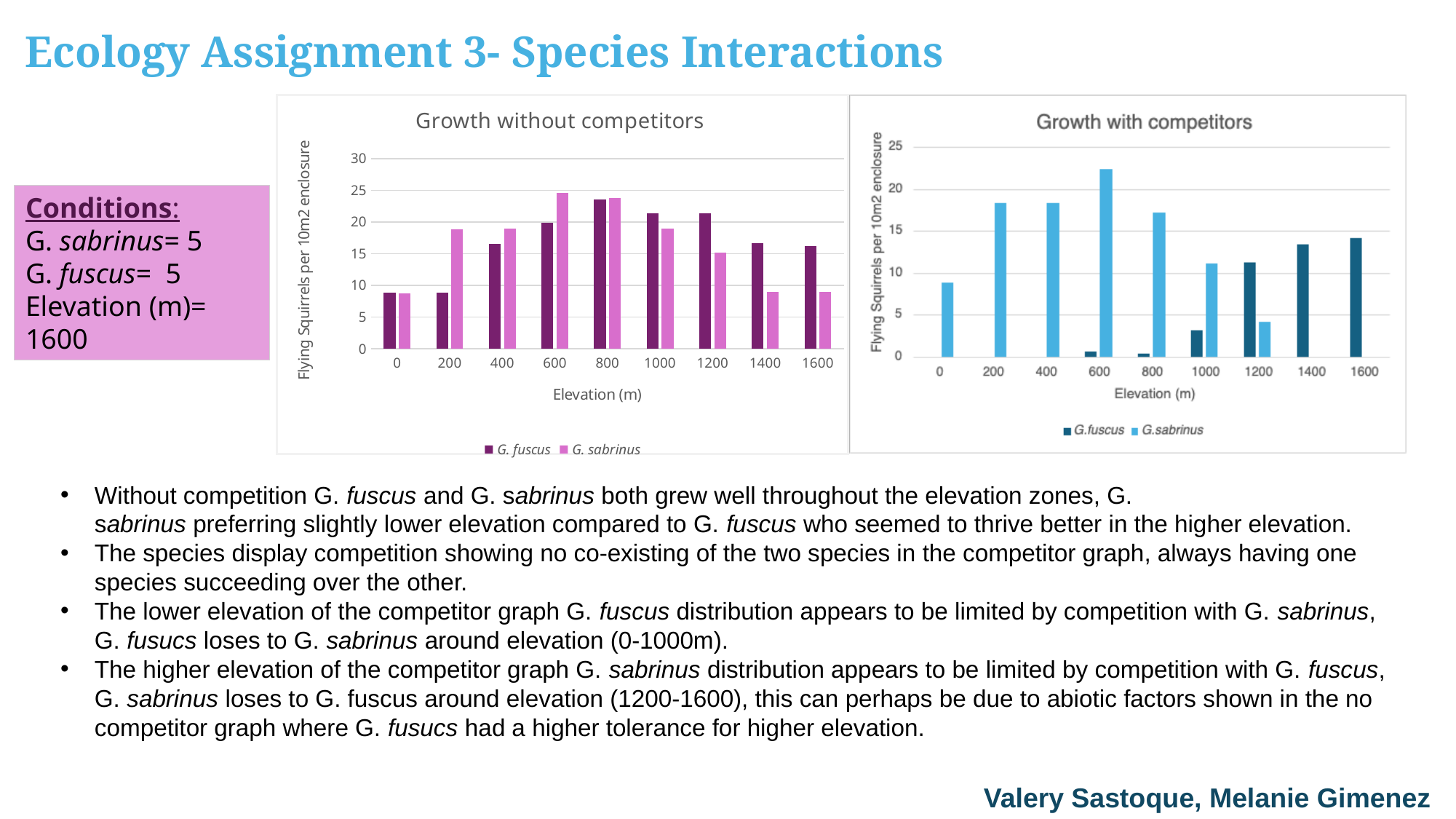
In the 'Growth with competitors' chart, is the value for G. sabrinus at elevation 600 greater or less than 20? greater In the 'Growth without competitors' chart, is the value for G. fuscus at elevation 400 greater or less than 15? greater What is the y-axis label of the 'Growth without competitors' chart? Flying Squirrels per 10m2 enclosure In the 'Growth with competitors' chart, do the G. sabrinus values rise or fall from elevation 600 to 1600? fall In the 'Growth with competitors' chart, do the G. fuscus values generally rise or fall as elevation increases? rise In the 'Growth without competitors' chart, which species has the larger value at elevation 200? G. sabrinus What kind of chart is the 'Growth without competitors' chart? bar chart How many elevation categories are shown on the x axis of the 'Growth without competitors' chart? 9 In the 'Growth with competitors' chart, which species has the larger value at elevation 1200? G. fuscus In the 'Growth with competitors' chart, at which elevation is the G. sabrinus bar highest? 600 In the 'Growth without competitors' chart, at which elevation is the G. fuscus bar highest? 800 How many series does the legend of the 'Growth with competitors' chart list? 2